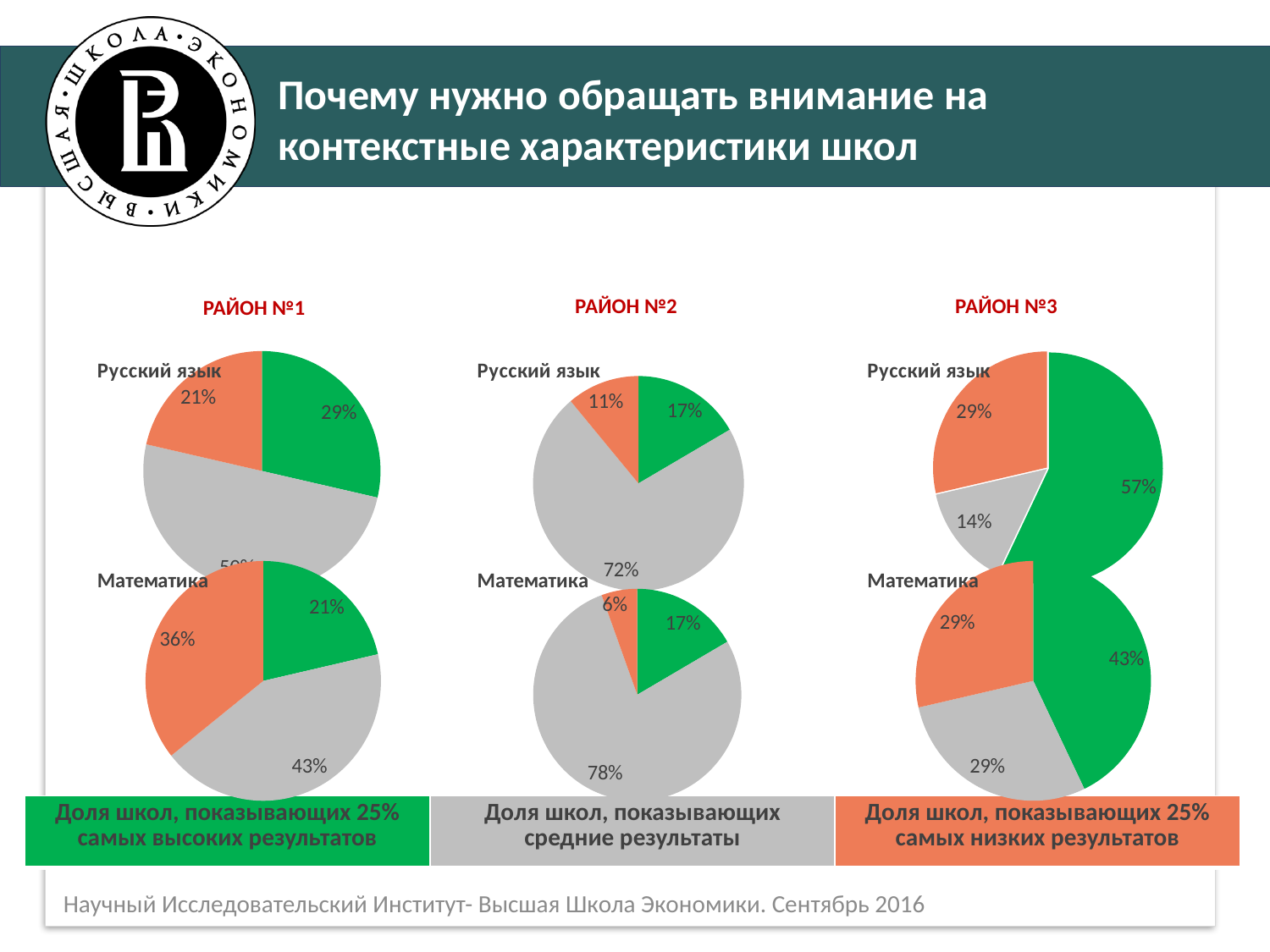
In the Район №2 Русский язык pie chart, what share of schools shows average results (grey slice)? 72% In the Район №2 Математика pie chart, which category has the largest share? Доля школ, показывающих средние результаты In the Район №1 Математика pie chart, what share of schools shows the 25% lowest results (orange slice)? 36% In the Район №3 Русский язык pie chart, what share of schools shows the 25% highest results (green slice)? 57% In the Район №2 Математика pie chart, what share of schools shows the 25% lowest results (orange slice)? 6% In the Район №3 Математика pie chart, what share of schools shows the 25% highest results (green slice)? 43% In the Район №3 Русский язык pie chart, which category has the smallest share? Доля школ, показывающих средние результаты How many pie charts are shown on the slide? 6 In the Район №1 Русский язык pie chart, what share of schools shows the 25% highest results (green slice)? 29% What type of charts are shown on the slide? Pie charts Which is larger: the share of schools with the 25% highest results in Район №3 Русский язык or in Район №2 Русский язык? Район №3 Русский язык In the Район №1 Математика pie chart, what is the difference between the share of schools with average results and the share with the 25% highest results? 22%